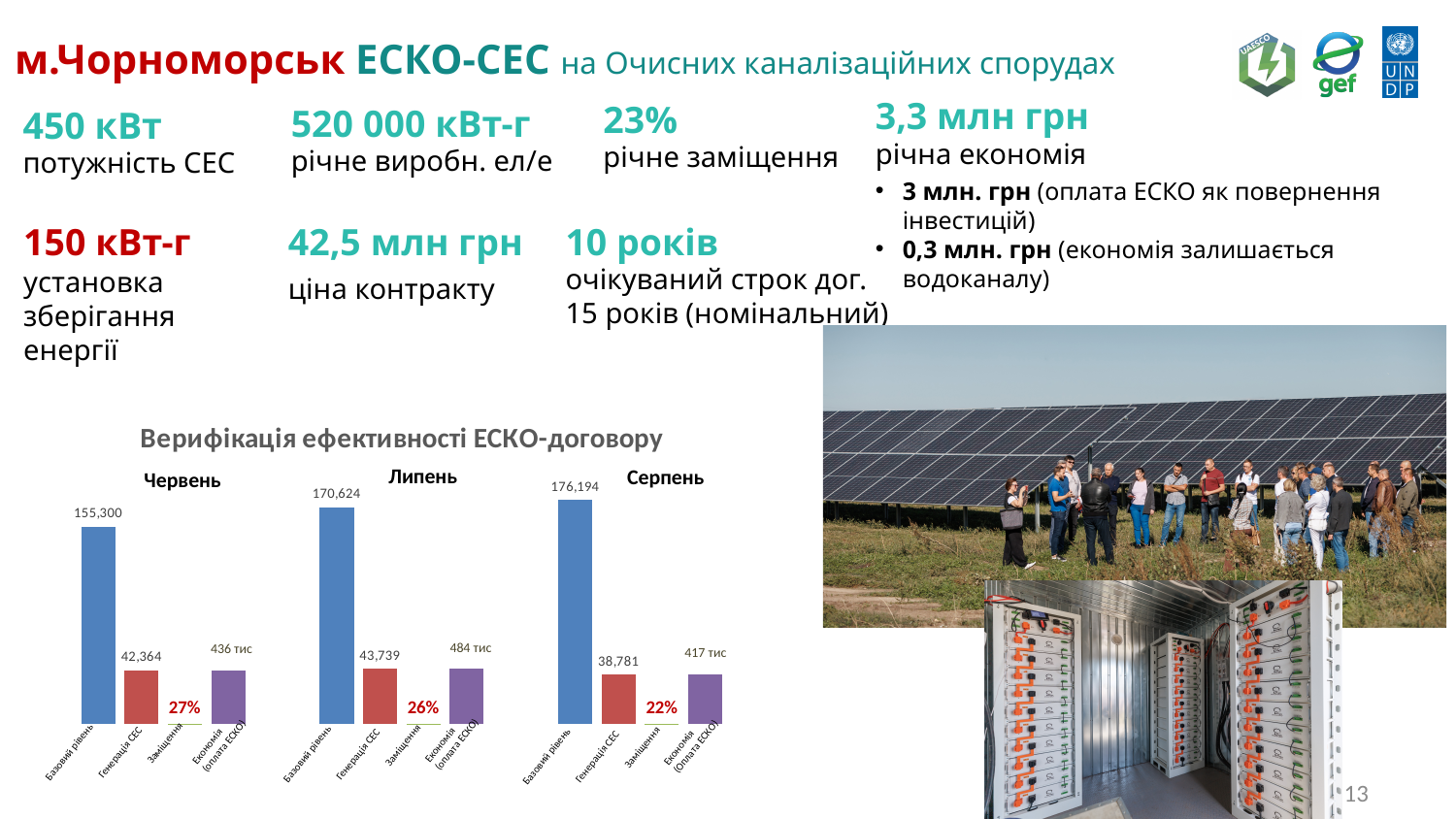
In the Липень chart, what is the value for Генерація СЕС? 43,739 In the Липень chart, what is the value for Економія (оплата ЕСКО)? 484 тис How many categories does the Серпень chart show? 4 What is the title above the three monthly charts? Верифікація ефективності ЕСКО-договору In the Серпень chart, what is the value for Заміщення? 22% In the Червень chart, which category has the highest value? Базовий рівень In the Червень chart, what is the value for Базовий рівень? 155,300 What type of chart is the Липень chart? Bar chart How many separate monthly charts are shown under the heading Верифікація ефективності ЕСКО-договору? 3 Which is larger: Генерація СЕС in the Липень chart or Генерація СЕС in the Серпень chart? Липень (43,739) In the Червень chart, what is the difference between Базовий рівень and Генерація СЕС? 112,936 In the Серпень chart, what is the value for Базовий рівень? 176,194